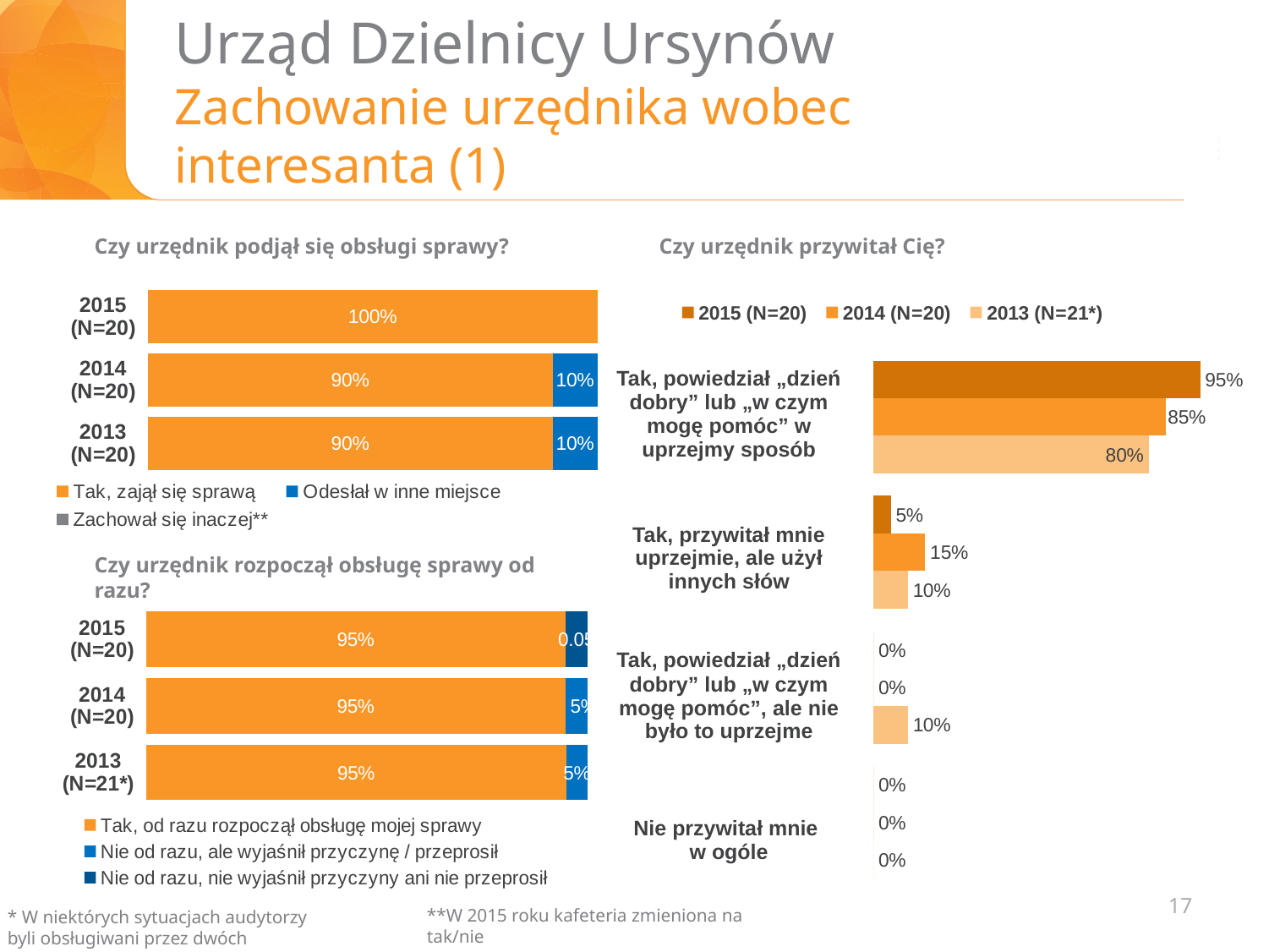
In the chart 'Czy urzędnik przywitał Cię?', which year has the larger value for 'Tak, przywitał mnie uprzejmie, ale użył innych słów': 2014 (N=20) or 2013 (N=21*)? 2014 (N=20) In the chart 'Czy urzędnik podjął się obsługi sprawy?', what is the value for 'Tak, zajął się sprawą' in 2015 (N=20)? 100% How many answer categories are shown in the chart 'Czy urzędnik przywitał Cię?'? 4 In the chart 'Czy urzędnik rozpoczął obsługę sprawy od razu?', what is the value for 'Tak, od razu rozpoczął obsługę mojej sprawy' in 2013 (N=21*)? 95% How many series does the legend of the chart 'Czy urzędnik podjął się obsługi sprawy?' list? 3 In the chart 'Czy urzędnik podjął się obsługi sprawy?', what is the value for 'Odesłał w inne miejsce' in 2014 (N=20)? 10% What kind of chart is 'Czy urzędnik rozpoczął obsługę sprawy od razu?'? bar chart In the chart 'Czy urzędnik przywitał Cię?', which year has the highest value for 'Tak, powiedział „dzień dobry” lub „w czym mogę pomóc” w uprzejmy sposób'? 2015 (N=20) In the chart 'Czy urzędnik przywitał Cię?', what is the 2014 (N=20) value for 'Tak, przywitał mnie uprzejmie, ale użył innych słów'? 15% In the chart 'Czy urzędnik przywitał Cię?', what is the difference between the 2015 and 2013 values for 'Tak, powiedział „dzień dobry” lub „w czym mogę pomóc” w uprzejmy sposób'? 15% How many year categories are shown in the chart 'Czy urzędnik rozpoczął obsługę sprawy od razu?'? 3 In the chart 'Czy urzędnik przywitał Cię?', what is the 2015 (N=20) value for 'Tak, powiedział „dzień dobry” lub „w czym mogę pomóc” w uprzejmy sposób'? 95%